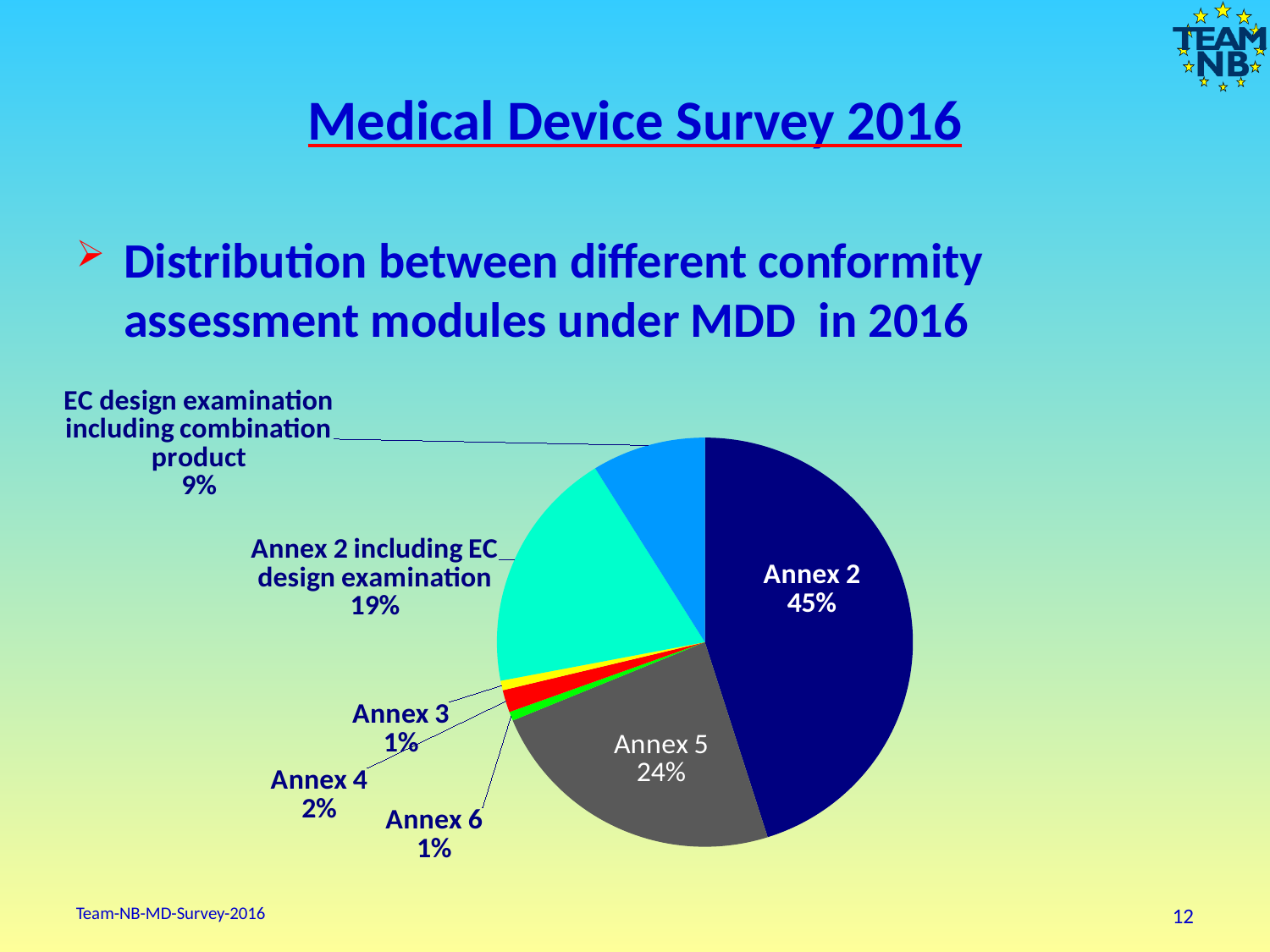
Which slice of the pie is the largest? Annex 2 What kind of chart is shown on the slide? pie chart Which is larger, the share for Annex 5 or the share for 'Annex 2 including EC design examination'? Annex 5 What percentage is shown for 'EC design examination including combination product'? 9% What percentage is shown for 'Annex 2 including EC design examination'? 19% What is the difference in percentage points between Annex 4 and Annex 3? 1 What percentage is shown for Annex 4? 2% How many slices does the pie chart have? 7 What share of the pie does Annex 5 represent? 24% What share of the pie does Annex 2 represent? 45% What is the difference in percentage points between Annex 2 and Annex 5? 21 What colour is the Annex 5 slice of the pie? grey